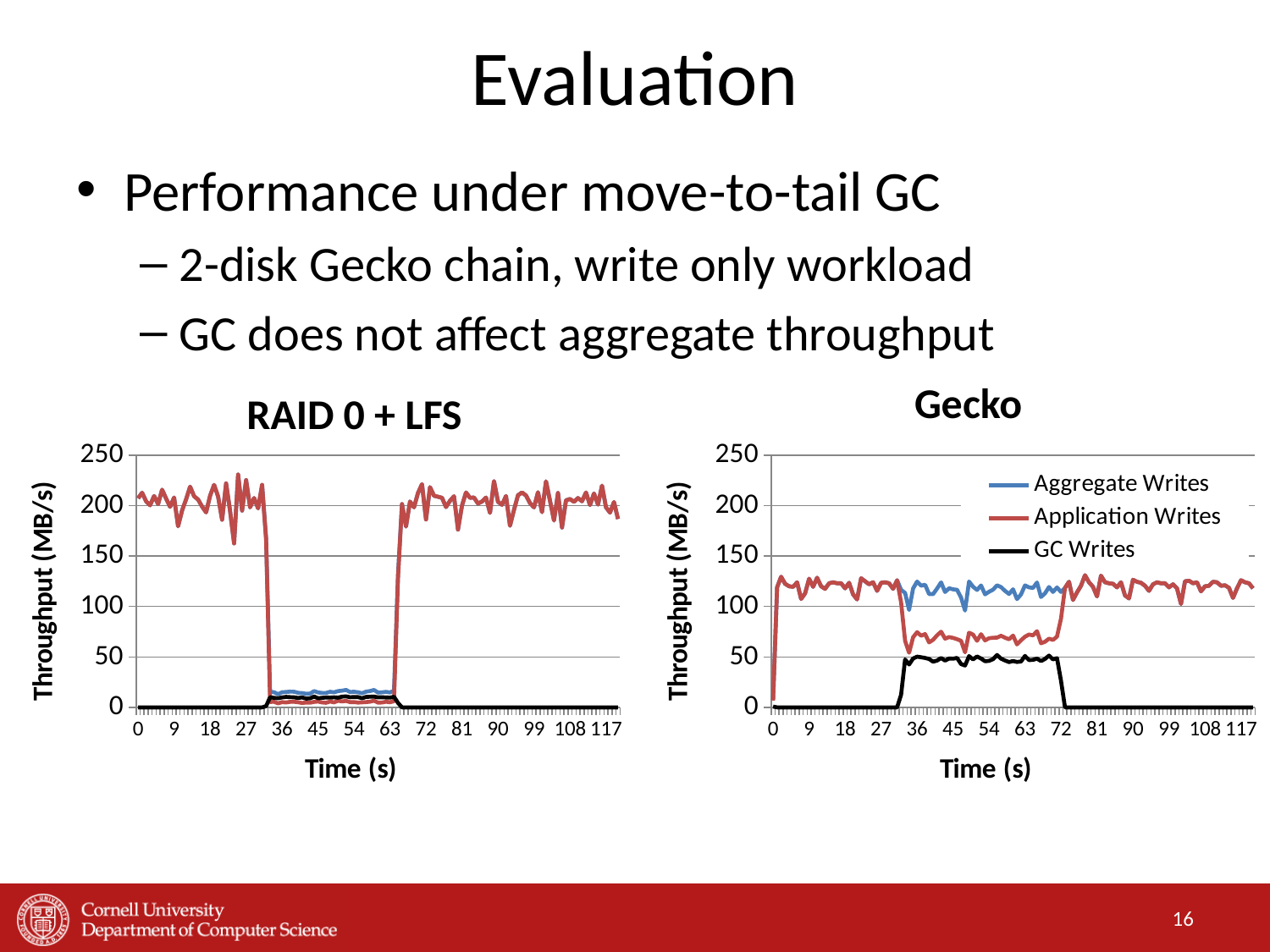
In the Gecko chart, is the Aggregate Writes value at time 54 greater or less than 100? greater In the RAID 0 + LFS chart, is the Application Writes value at time 9 greater or less than 150? greater In the Gecko chart, is the GC Writes value at time 54 greater or less than 100? less What kind of chart is the RAID 0 + LFS chart? line chart In the Gecko chart, which series is drawn in black according to the legend? GC Writes What kind of chart is the Gecko chart? line chart What is the y-axis label of the Gecko chart? Throughput (MB/s) In the Gecko chart at time 54, which is larger, Application Writes or GC Writes? Application Writes How many series does the legend of the Gecko chart list? 3